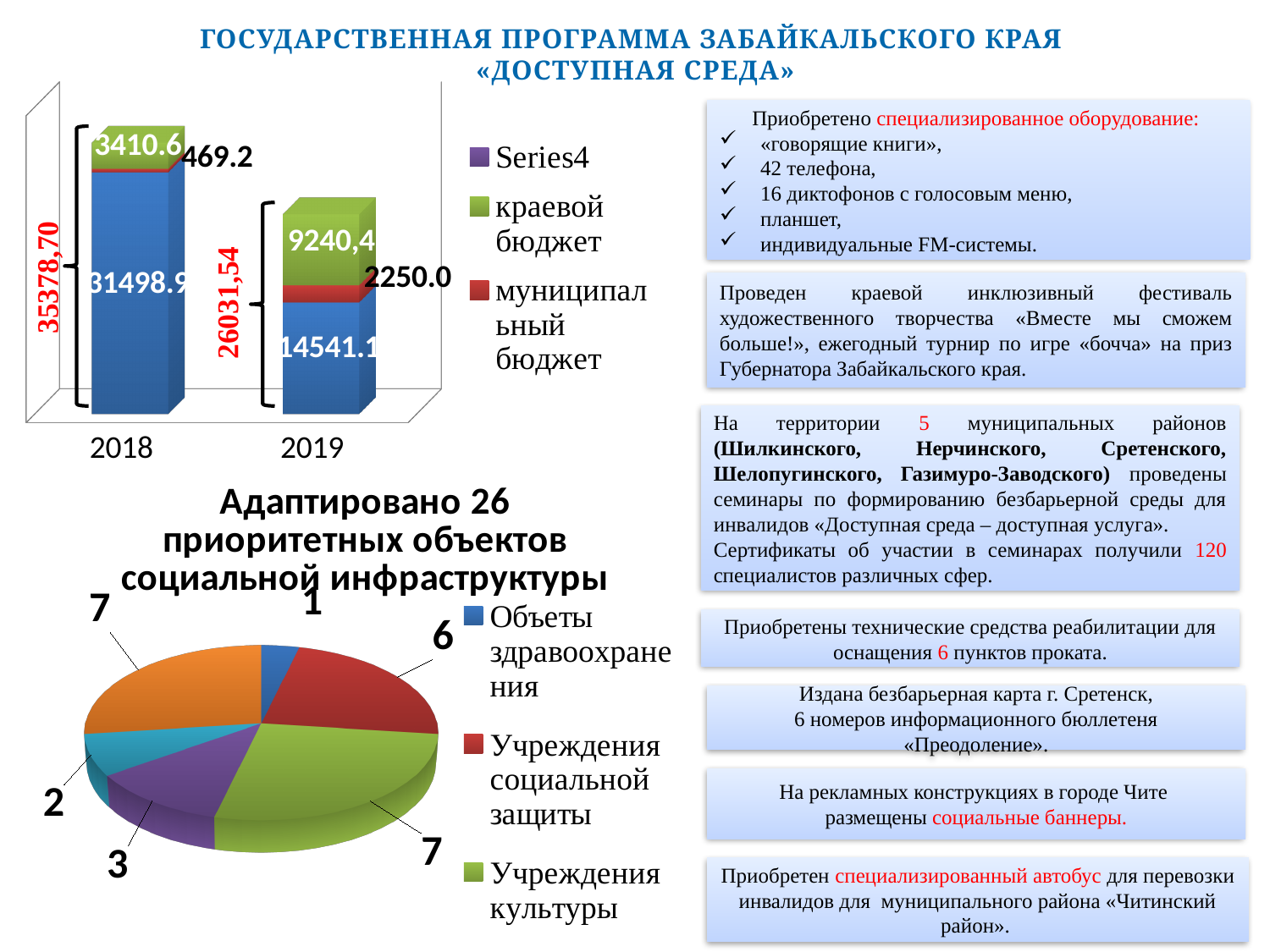
In the top-left bar chart, which year has the larger value for краевой бюджет, 2018 or 2019? 2019 In the top-left bar chart, by how much does муниципальный бюджет in 2019 exceed муниципальный бюджет in 2018? 1780.8 In the pie chart 'Адаптировано 26 приоритетных объектов социальной инфраструктуры', what is the value for Учреждения культуры? 7 In the top-left bar chart, what is the value of краевой бюджет for 2019? 9240,4 In the pie chart 'Адаптировано 26 приоритетных объектов социальной инфраструктуры', what is the value for Объекты здравоохранения? 1 How many years (categories) are shown on the x axis of the top-left bar chart? 2 In the pie chart 'Адаптировано 26 приоритетных объектов социальной инфраструктуры', what is the value for Учреждения социальной защиты? 6 In the top-left bar chart, what is the total shown for the 2019 stacked bar? 26031,54 In the top-left bar chart, what is the value of муниципальный бюджет for 2018? 469.2 How many slices does the pie chart 'Адаптировано 26 приоритетных объектов социальной инфраструктуры' have? 6 In the top-left bar chart, what is the total shown for the 2018 stacked bar? 35378,70 What kind of chart is the top-left chart on the slide? bar chart